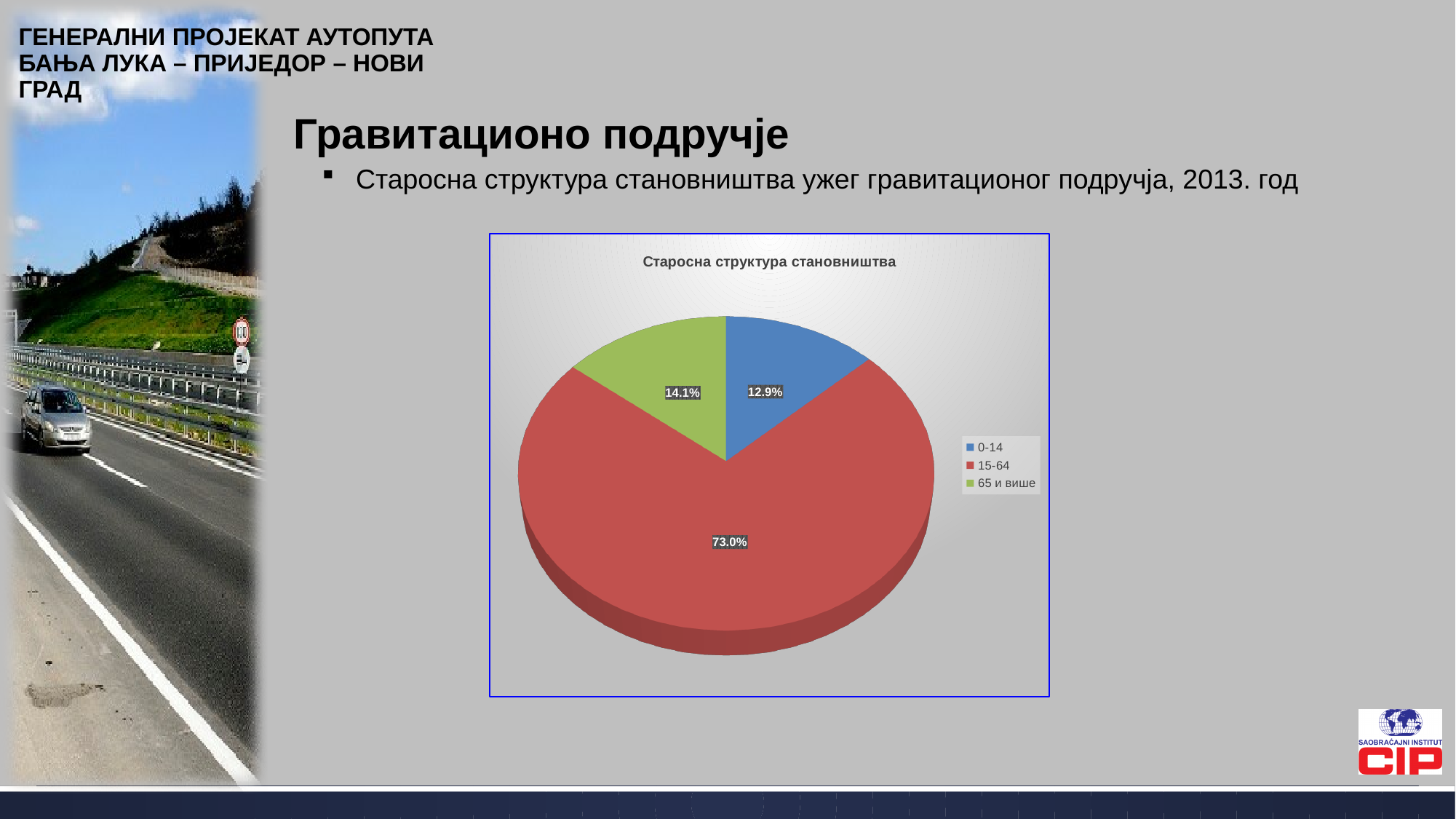
What is the title of the chart? Старосна структура становништва Which is larger, the share for 0-14 or the share for '65 и више'? 65 и више What share of the pie does the 0-14 age group have? 12.9% What colour is the slice for the 15-64 age group? red What share of the pie does the 15-64 age group have? 73.0% Which age group has the largest share of the pie? 15-64 What kind of chart is shown on the slide? pie chart How many entries does the legend list? 3 What is the difference in percentage points between the 15-64 share and the '65 и више' share? 58.9 Which age group has the smallest share of the pie? 0-14 How many slices does the pie chart have? 3 What share of the pie does the '65 и више' age group have? 14.1%